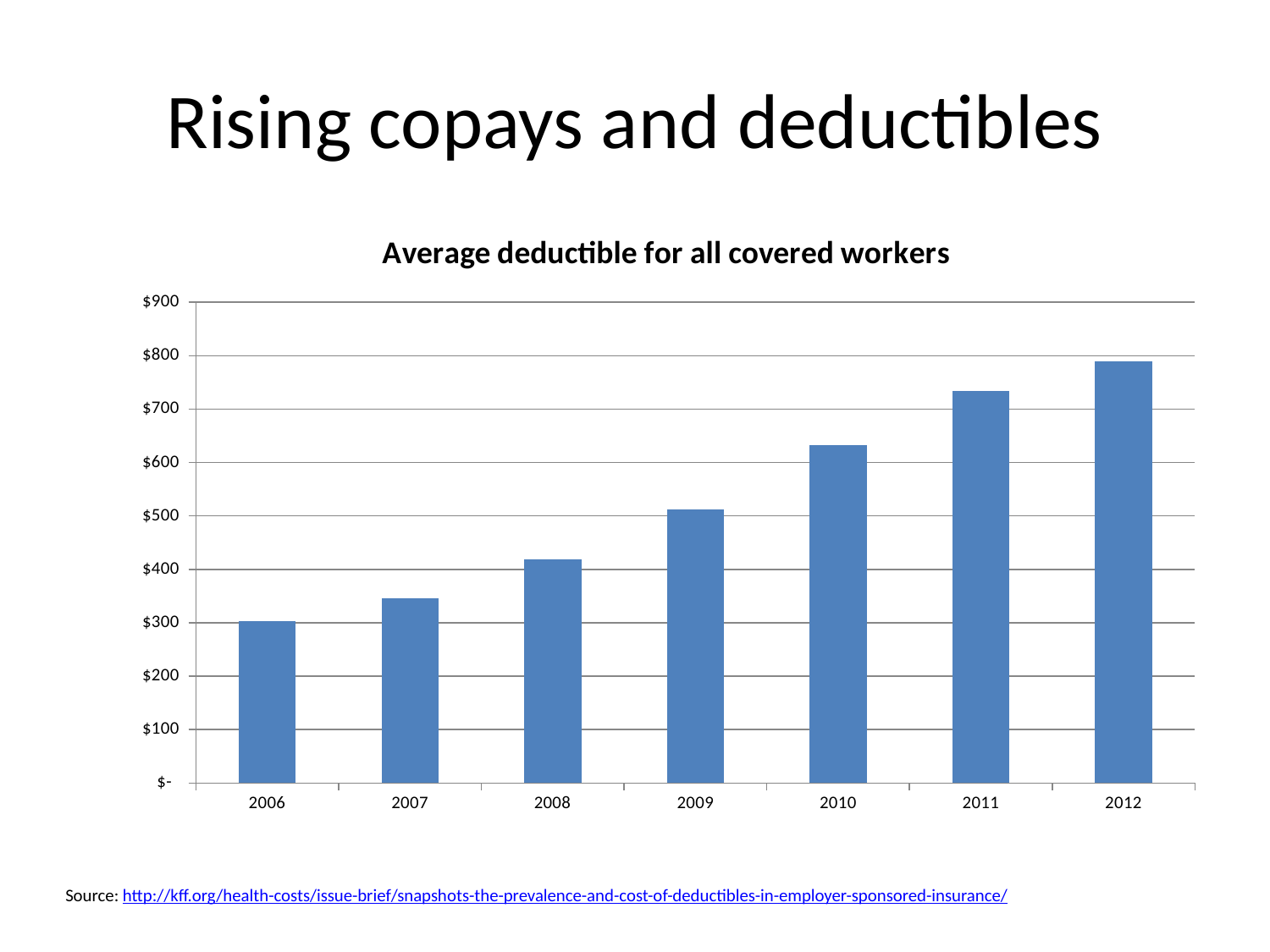
Is the value for 2007 greater or less than $300? greater Which year has the highest average deductible? 2012 Which is larger, the value for 2009 or the value for 2011? 2011 What is the title of the chart? Average deductible for all covered workers Which year has the lowest average deductible? 2006 Is the value for 2012 greater or less than $700? greater How many years are shown on the x axis of the chart? 7 Do the average deductible values rise or fall from 2006 to 2012? rise Is the value for 2008 greater or less than $500? less What type of chart is shown on the slide? bar chart